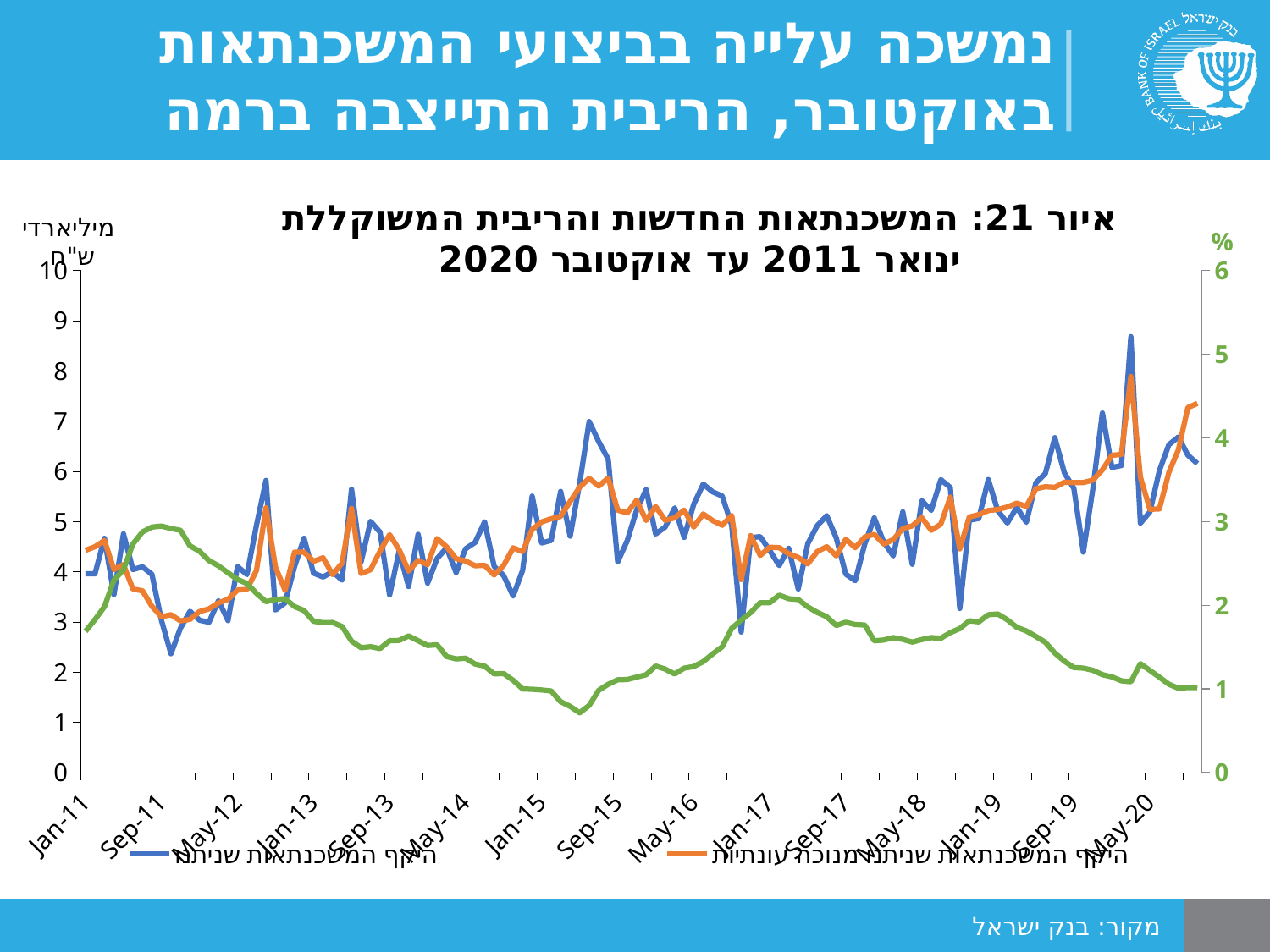
Does the orange line (היקף המשכנתאות שניתנו מנוכה עונתיות) overall rise or fall from Jan-11 to 2020? rise How many series does the legend list? 2 Is the lowest point of the blue line (היקף המשכנתאות שניתנו), around early 2012, greater or less than 3 on the left axis? less What is the title of the chart? איור 21: המשכנתאות החדשות והריבית המשוקללת ינואר 2011 עד אוקטובר 2020 What kind of chart is shown on the slide? line chart Does the green line overall rise or fall from Jan-11 to 2020? fall Is the green line's peak around Sep-11 greater or less than 2 on the right % axis? greater Around which x-axis label does the blue line (היקף המשכנתאות שניתנו) reach its highest value? May-20 What unit is shown on the left vertical axis? מיליארדי ש"ח Is the green line's value at the end of the series (2020) greater or less than 2 on the right % axis? less